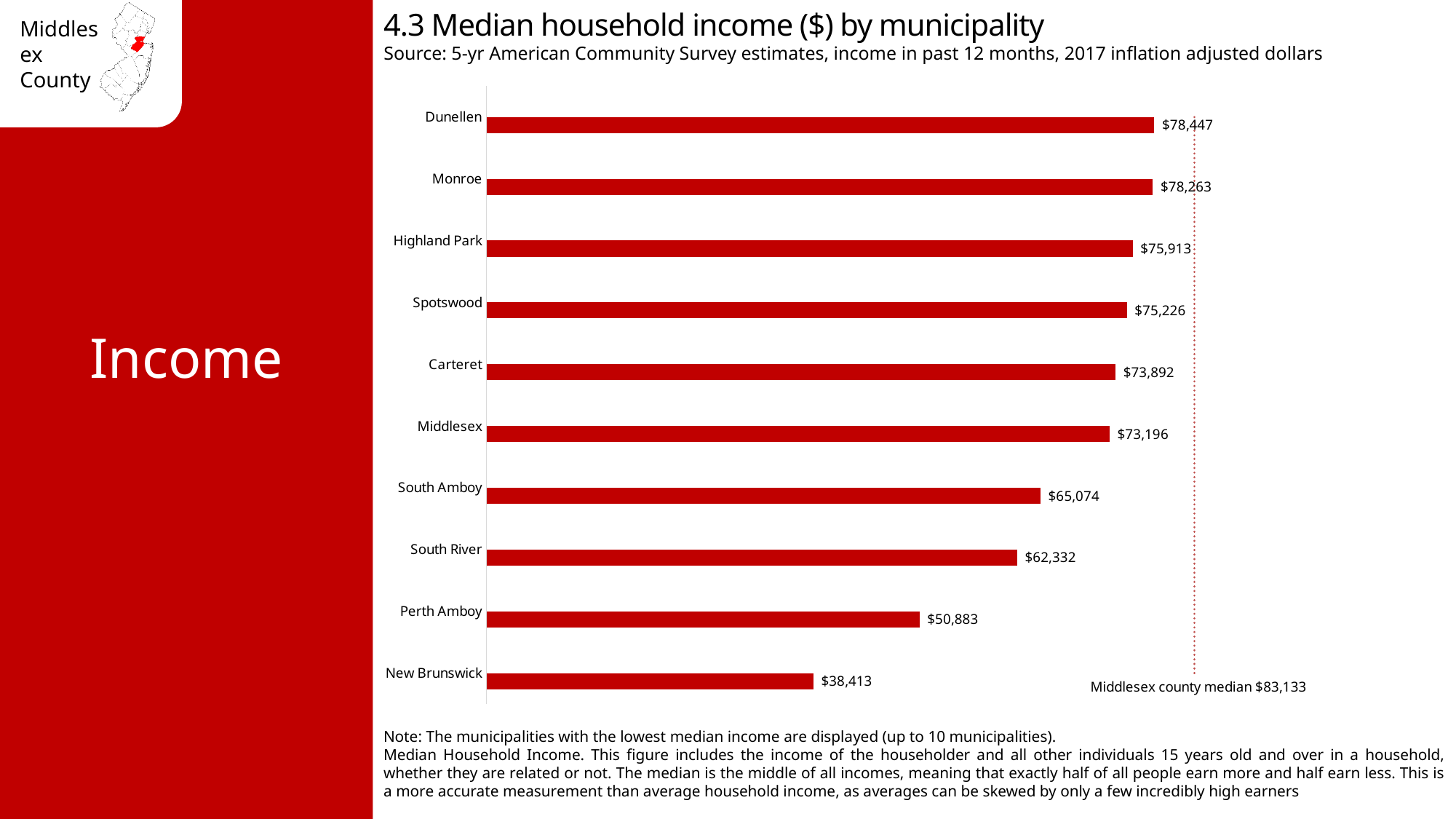
What is the median household income for South River? $62,332 What is the difference between the median household income of Perth Amboy and New Brunswick? $12,470 How many municipalities are shown on the chart? 10 What is the difference between the median household income of Dunellen and New Brunswick? $40,034 What is the median household income for Carteret? $73,892 What value does the dotted vertical line on the chart represent? Middlesex county median $83,133 Which municipality has the lowest median household income on the chart? New Brunswick What is the median household income for New Brunswick? $38,413 What kind of chart is used to show median household income by municipality? Bar chart Which municipality has the highest median household income on the chart? Dunellen Which has a higher median household income, South Amboy or Perth Amboy? South Amboy What is the median household income for Dunellen? $78,447